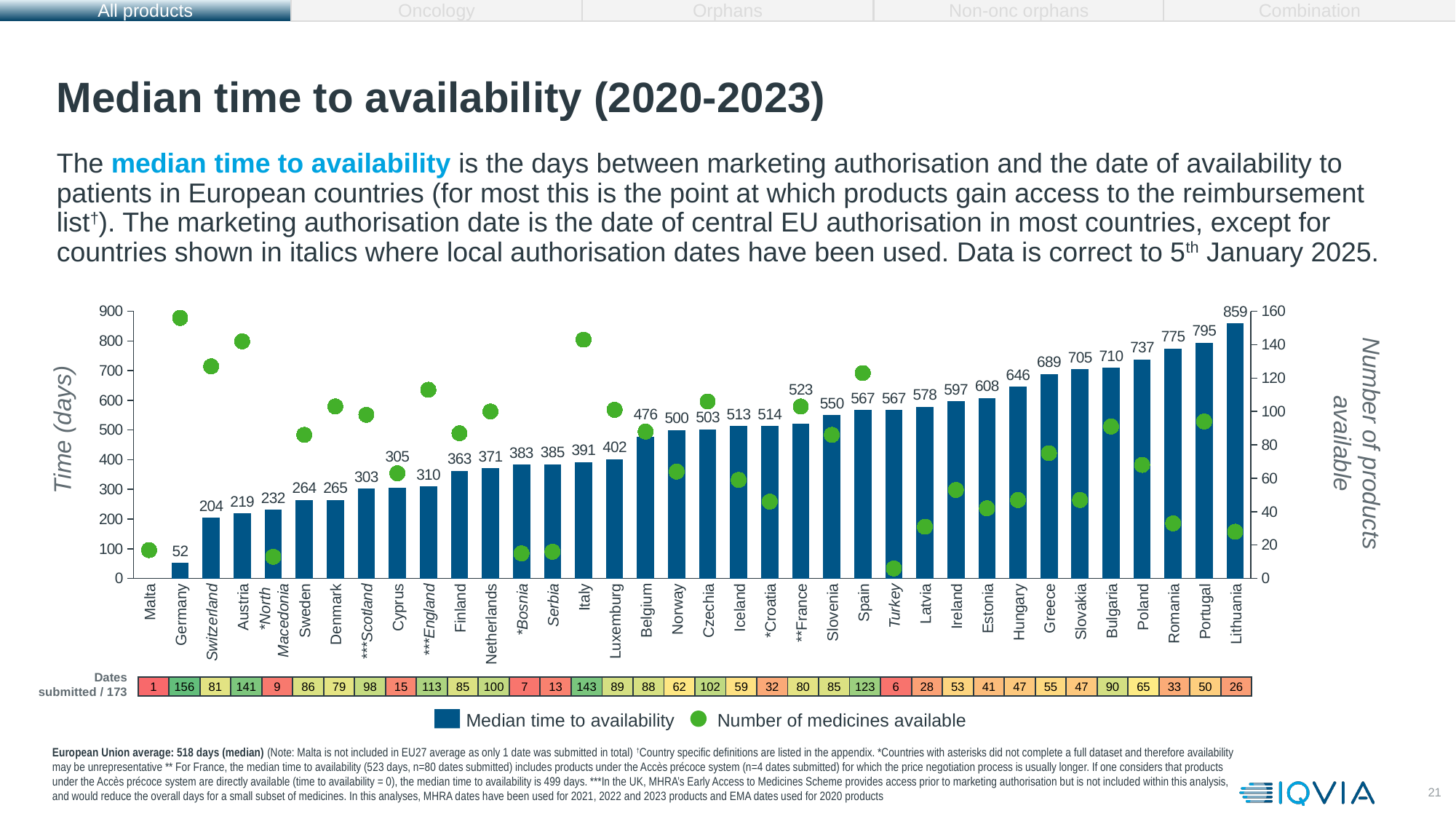
Do the median time to availability bars rise or fall from left to right across the chart? rise How many series does the chart legend list? 2 Which has a longer median time to availability, Poland or Greece? Poland Is the number of medicines available for Germany greater or less than 140? greater What is the median time to availability for Lithuania? 859 Which country has the highest median time to availability? Lithuania How many countries are shown on the x axis of the chart? 36 What is the median time to availability for France? 523 What is the difference in median time to availability between Portugal and Romania? 20 What kind of chart is used to show the median time to availability? bar chart Is the number of medicines available for Turkey greater or less than 20? less What is the median time to availability for Germany? 52